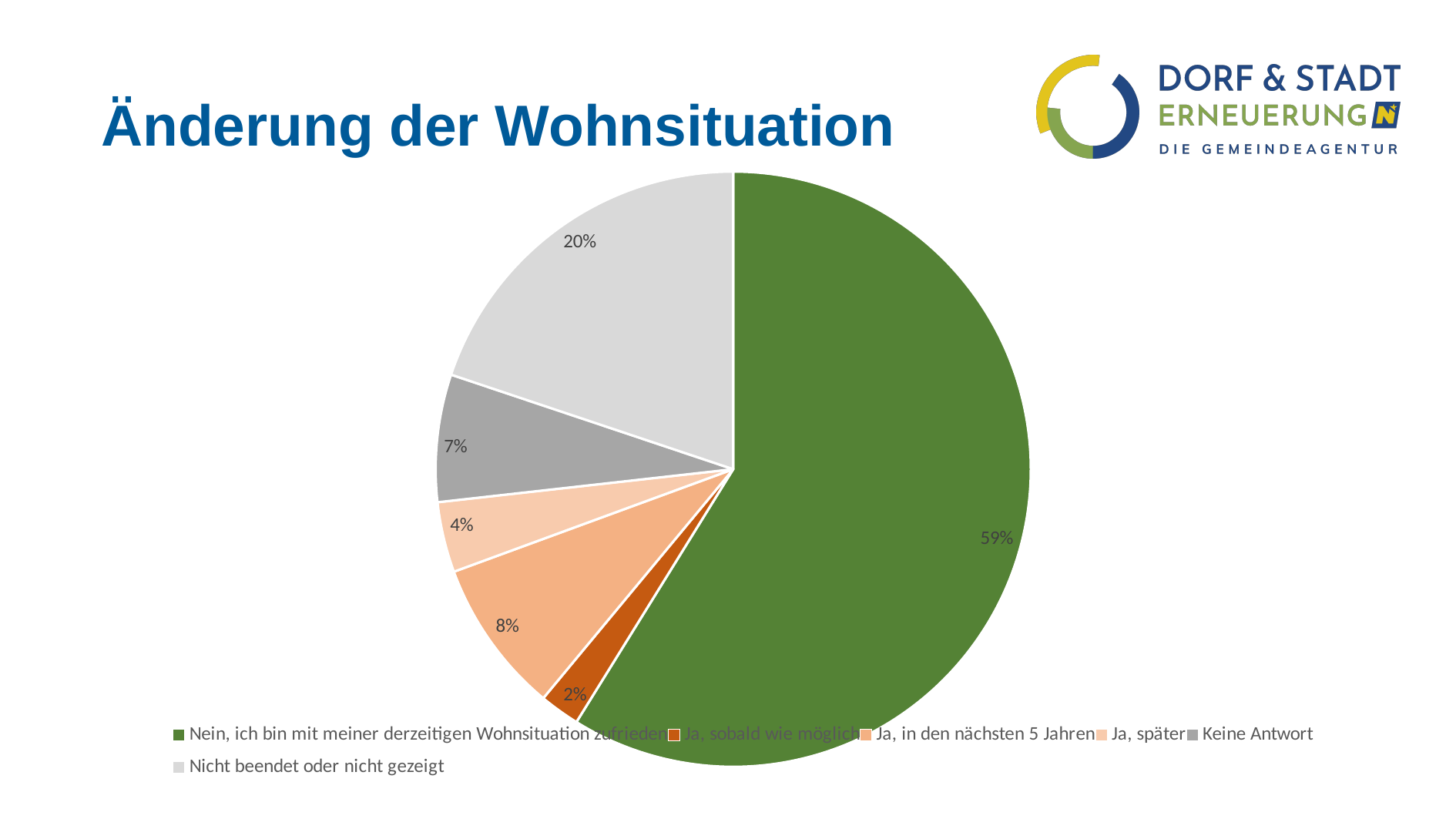
Which category has the smallest slice of the pie? Ja, sobald wie möglich What is the difference in percentage points between the "Nicht beendet oder nicht gezeigt" slice and the "Keine Antwort" slice? 13 What share of the pie is labelled "Nicht beendet oder nicht gezeigt"? 20% How many slices does the pie chart have? 6 What share of the pie is labelled "Keine Antwort"? 7% Which slice is larger: "Ja, in den nächsten 5 Jahren" or "Ja, später"? Ja, in den nächsten 5 Jahren What kind of chart is shown on the slide? pie chart What share of the pie is labelled "Nein, ich bin mit meiner derzeitigen Wohnsituation zufrieden"? 59% What is the title of the slide containing the pie chart? Änderung der Wohnsituation Which category has the largest slice of the pie? Nein, ich bin mit meiner derzeitigen Wohnsituation zufrieden What share of the pie is labelled "Ja, in den nächsten 5 Jahren"? 8% What share of the pie is labelled "Ja, später"? 4%